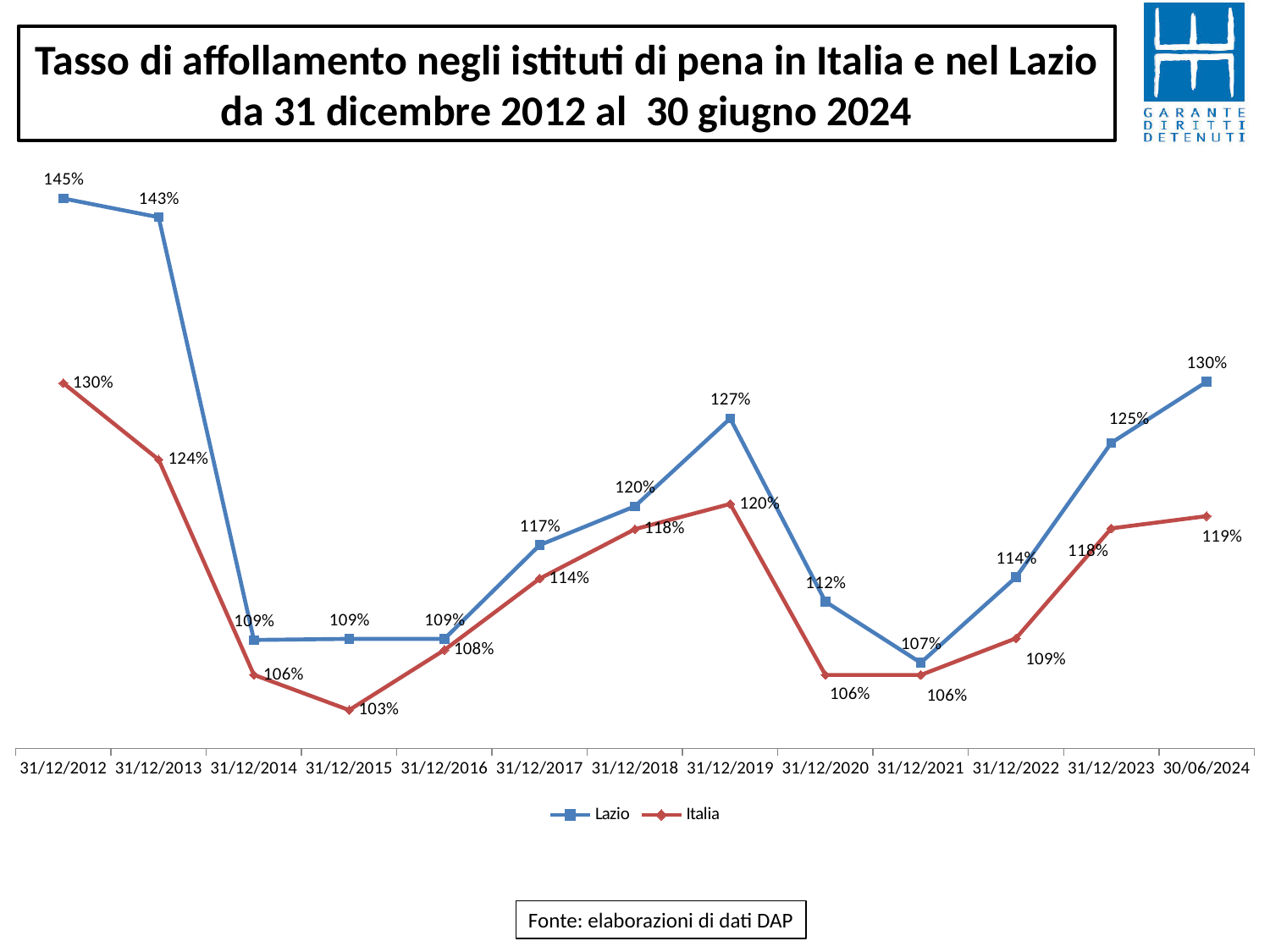
How many dates are plotted on the x axis? 13 What kind of chart is shown on the slide? Line chart How many series does the legend list? 2 Does the Lazio series rise or fall between 31/12/2021 and 30/06/2024? Rise What is the Lazio value at 30/06/2024? 130% At which date does the Italia series reach its lowest value? 31/12/2015 What is the difference between the Lazio and Italia values at 31/12/2013? 19% At which date does the Lazio series reach its highest value? 31/12/2012 What is the Italia value at 31/12/2015? 103% Which series has the higher value at 31/12/2021, Lazio or Italia? Lazio What is the Italia value at 31/12/2019? 120% What is the Lazio value at 31/12/2012? 145%